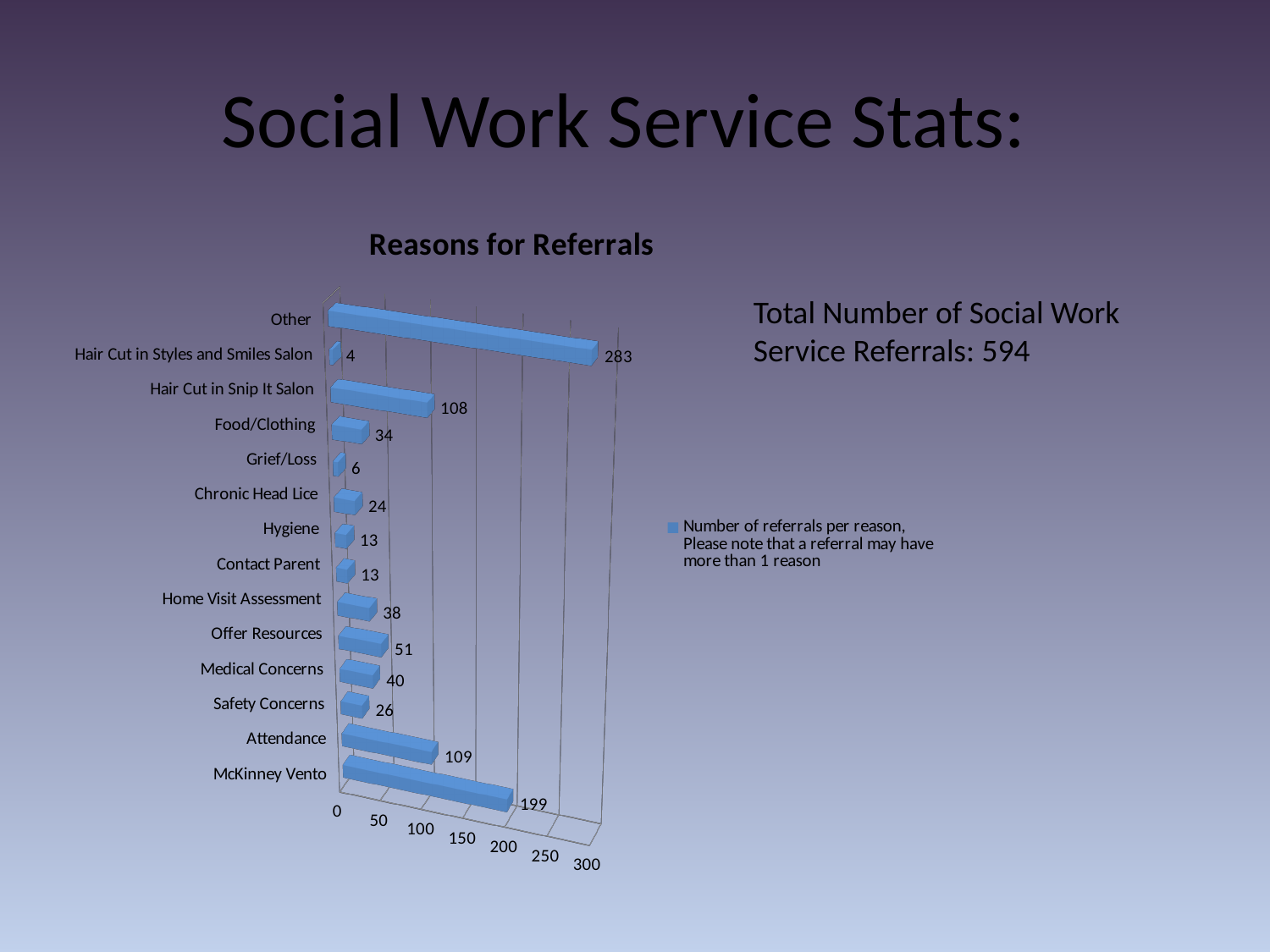
What is the title of the chart? Reasons for Referrals How many reasons for referral are shown in the chart? 14 What is the number of referrals for McKinney Vento? 199 What is the difference between the number of referrals for Home Visit Assessment and for Chronic Head Lice? 14 What is the difference between the number of referrals for Other and for McKinney Vento? 84 Which reason for referral has the highest number of referrals? Other What type of chart is shown on the slide? bar chart What is the number of referrals for Food/Clothing? 34 How many series does the legend list? 1 Which reason for referral has the lowest number of referrals? Hair Cut in Styles and Smiles Salon What is the number of referrals for Offer Resources? 51 Which has more referrals, Medical Concerns or Safety Concerns? Medical Concerns